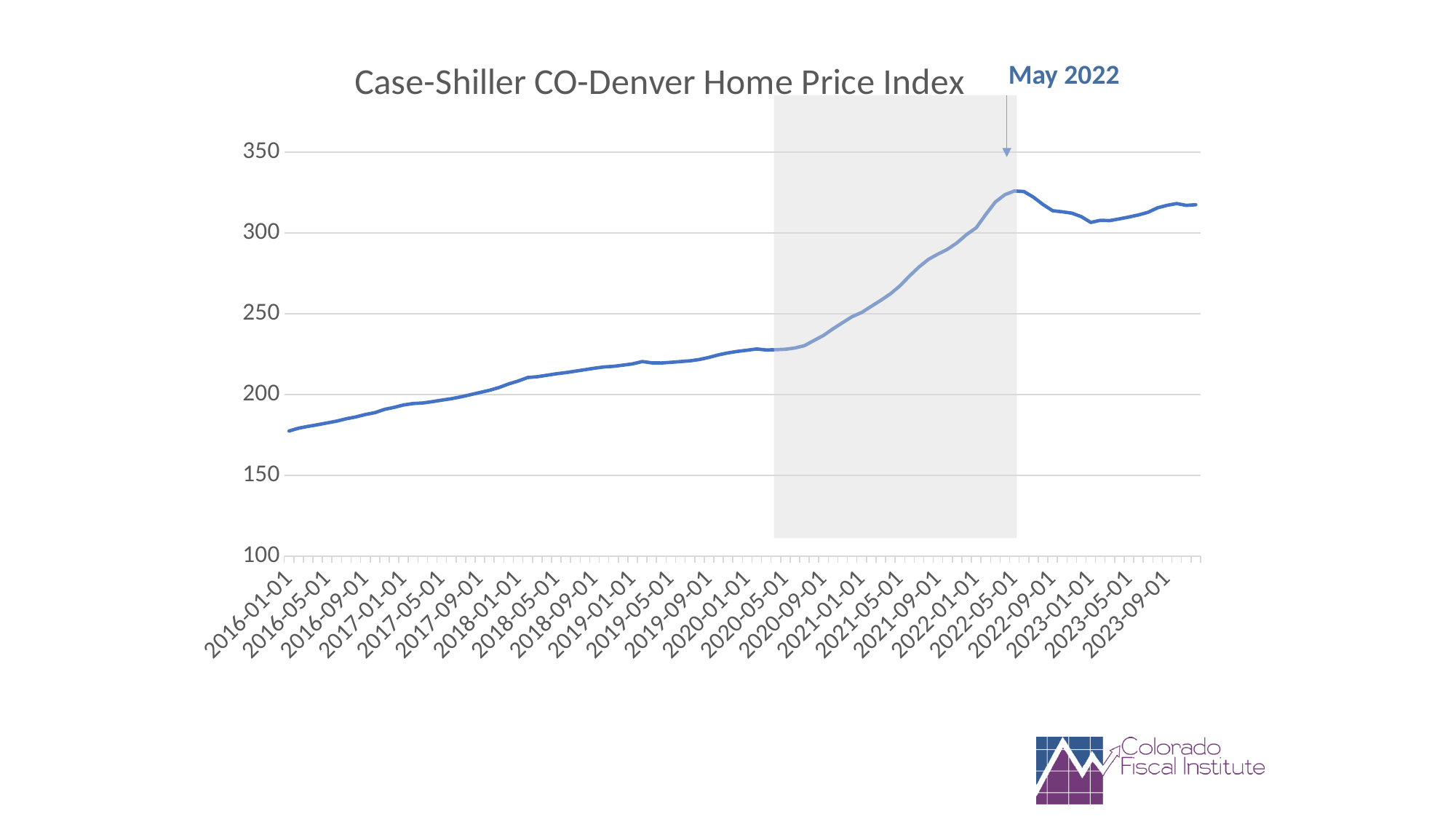
What kind of chart is shown on the slide? line chart Does the index rise or fall from May 2022 to 2023-01-01? fall Is the value for 2023-09-01 greater or less than 300? greater Does the index rise or fall from 2016-01-01 to 2022-05-01? rise Is the value for 2018-01-01 greater or less than 200? greater What is the title of the chart? Case-Shiller CO-Denver Home Price Index At which date is the Case-Shiller CO-Denver Home Price Index at its lowest? 2016-01-01 Which is larger, the index value for 2021-01-01 or for 2019-01-01? 2021-01-01 Is the value for 2022-05-01 greater or less than 300? greater Which month is annotated as the peak of the Case-Shiller CO-Denver Home Price Index? May 2022